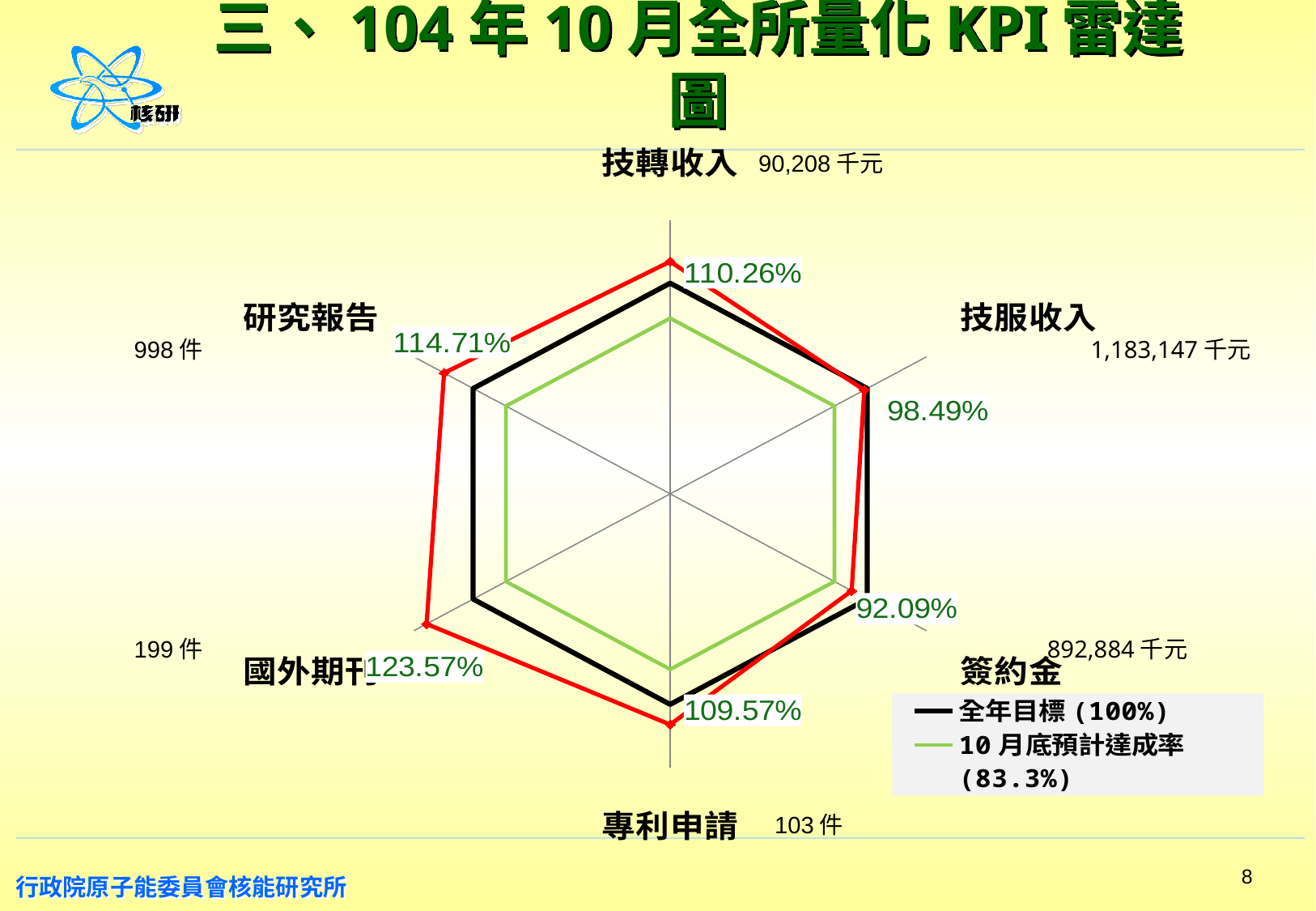
What is the annual target value shown for 專利申請? 103 件 What is the achievement rate shown for 技轉收入? 110.26% How many KPI axes does the radar chart have? 6 What is the achievement rate shown for 簽約金? 92.09% How many series does the legend list? 2 Which KPI axis has the highest achievement rate? 國外期刊 Which has a higher achievement rate, 研究報告 or 專利申請? 研究報告 What is the difference between the achievement rates of 國外期刊 and 簽約金? 31.48% What is the achievement rate shown for 技服收入? 98.49% Which KPI axis has the lowest achievement rate? 簽約金 What kind of chart is shown on the slide? Radar chart What is the achievement rate shown for 國外期刊? 123.57%